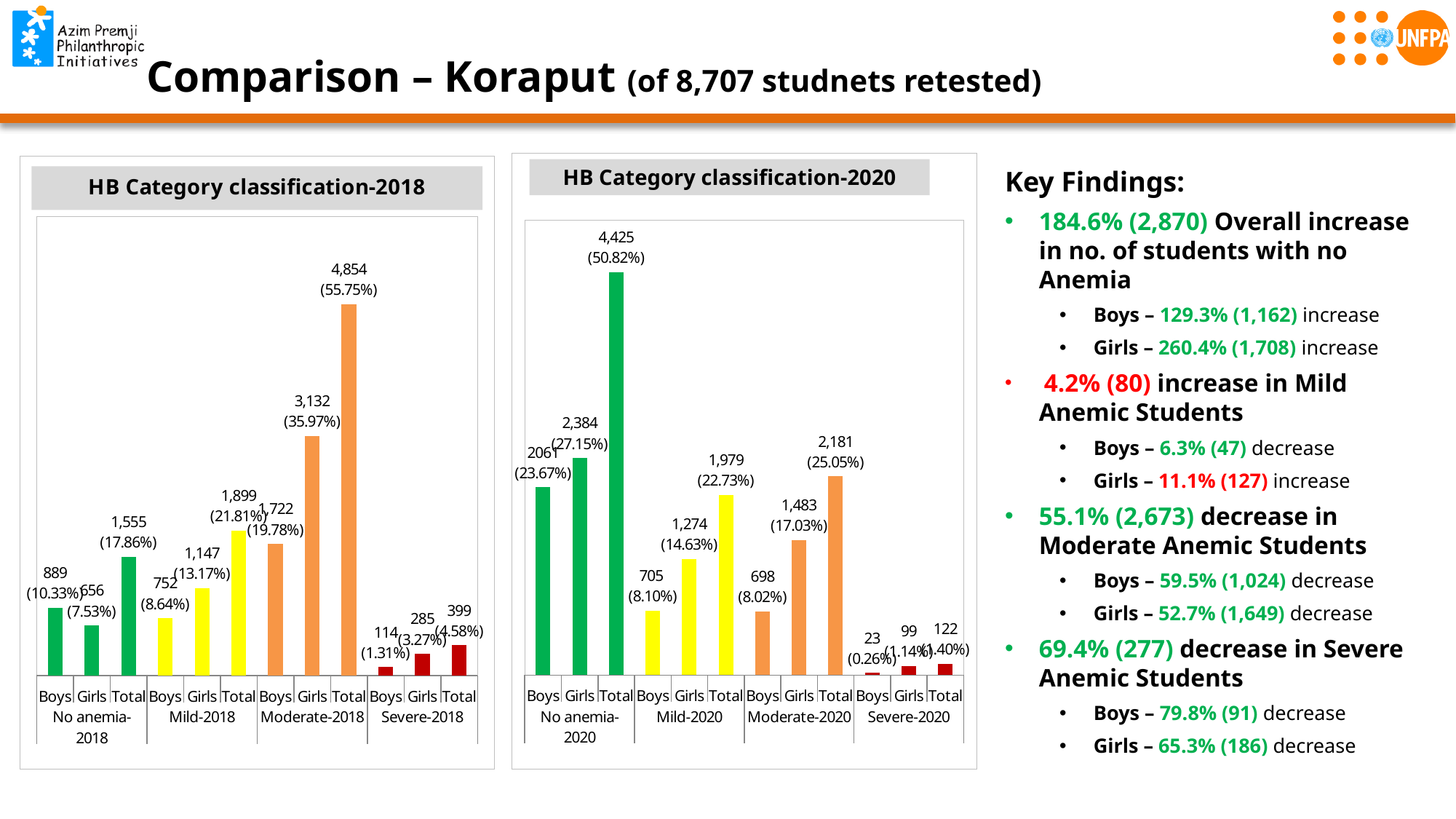
In the HB Category classification-2018 chart, what is the difference between Girls and Boys under Moderate-2018? 1,410 In the HB Category classification-2018 chart, what colour are the Severe-2018 bars? Dark red How many bars are plotted in the HB Category classification-2018 chart? 12 In the HB Category classification-2018 chart, what percentage is shown for Girls under Mild-2018? 13.17% In the HB Category classification-2018 chart, what is the value for Total under Moderate-2018? 4,854 In the HB Category classification-2020 chart, what is the difference between Girls and Boys under No anemia-2020? 323 In the HB Category classification-2020 chart, which bar is the lowest? Boys, Severe-2020 In the HB Category classification-2018 chart, which bar is the highest? Total, Moderate-2018 What type of chart is the HB Category classification-2020 chart? Bar chart In the HB Category classification-2020 chart, what is the value for Boys under Severe-2020? 23 In the HB Category classification-2020 chart, what is the value for Total under No anemia-2020? 4,425 In the HB Category classification-2020 chart, which is larger: Total under Mild-2020 or Total under Moderate-2020? Total under Moderate-2020